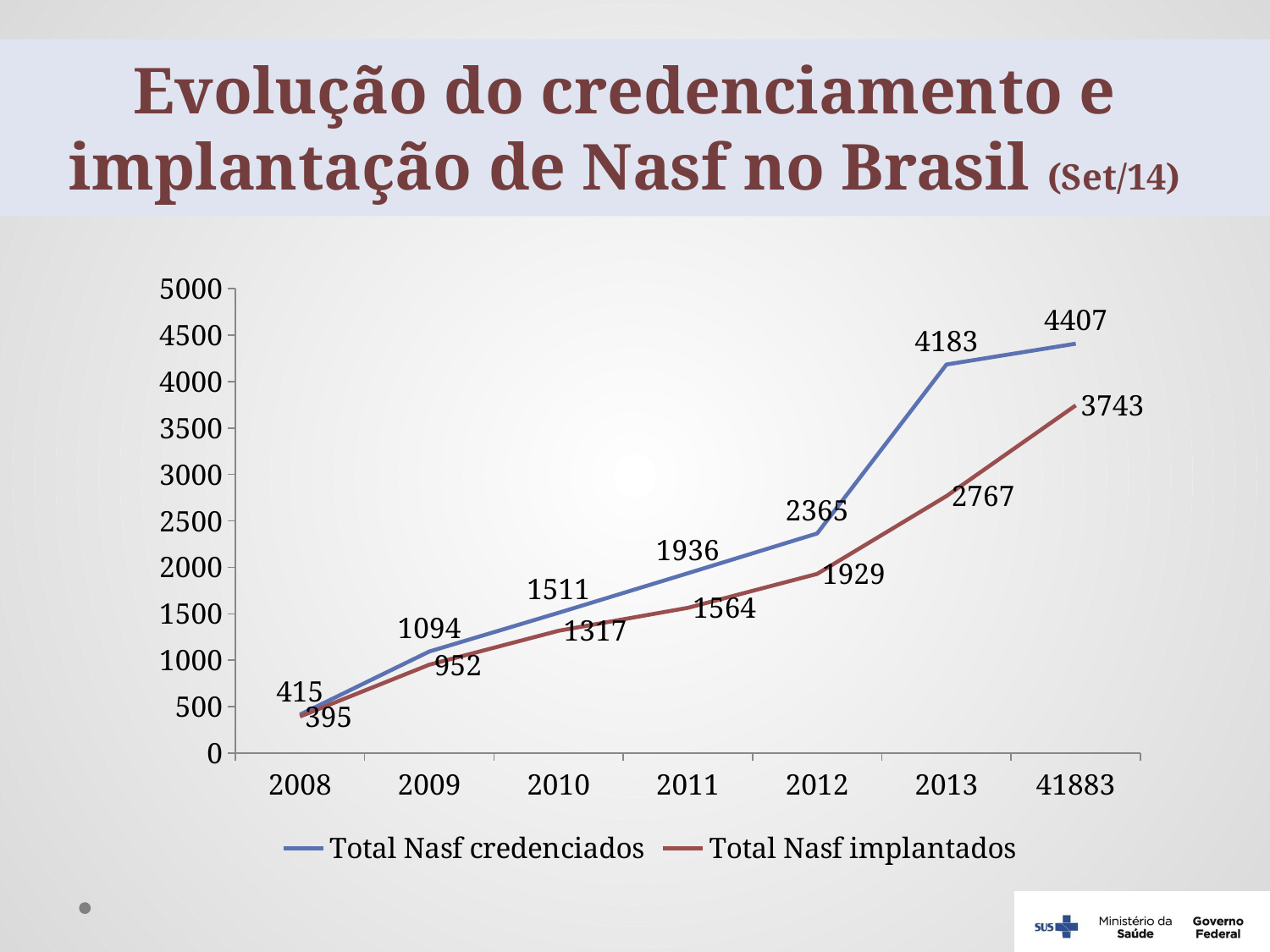
What kind of chart is shown on the slide? Line chart What is the value of Total Nasf implantados in 2010? 1317 What is the value of Total Nasf credenciados in 2013? 4183 What is the difference between Total Nasf credenciados and Total Nasf implantados in 2012? 436 What is the value of Total Nasf implantados at the last point on the x axis (labelled 41883)? 3743 What is the difference between Total Nasf credenciados in 2013 and in 2012? 1818 How many series does the legend list? 2 What is the value of Total Nasf credenciados in 2008? 415 Which is larger in 2011: Total Nasf credenciados or Total Nasf implantados? Total Nasf credenciados In which year is Total Nasf implantados lowest? 2008 How many points are plotted along the x axis for each series? 7 Do the values of Total Nasf implantados rise or fall along the x axis? Rise